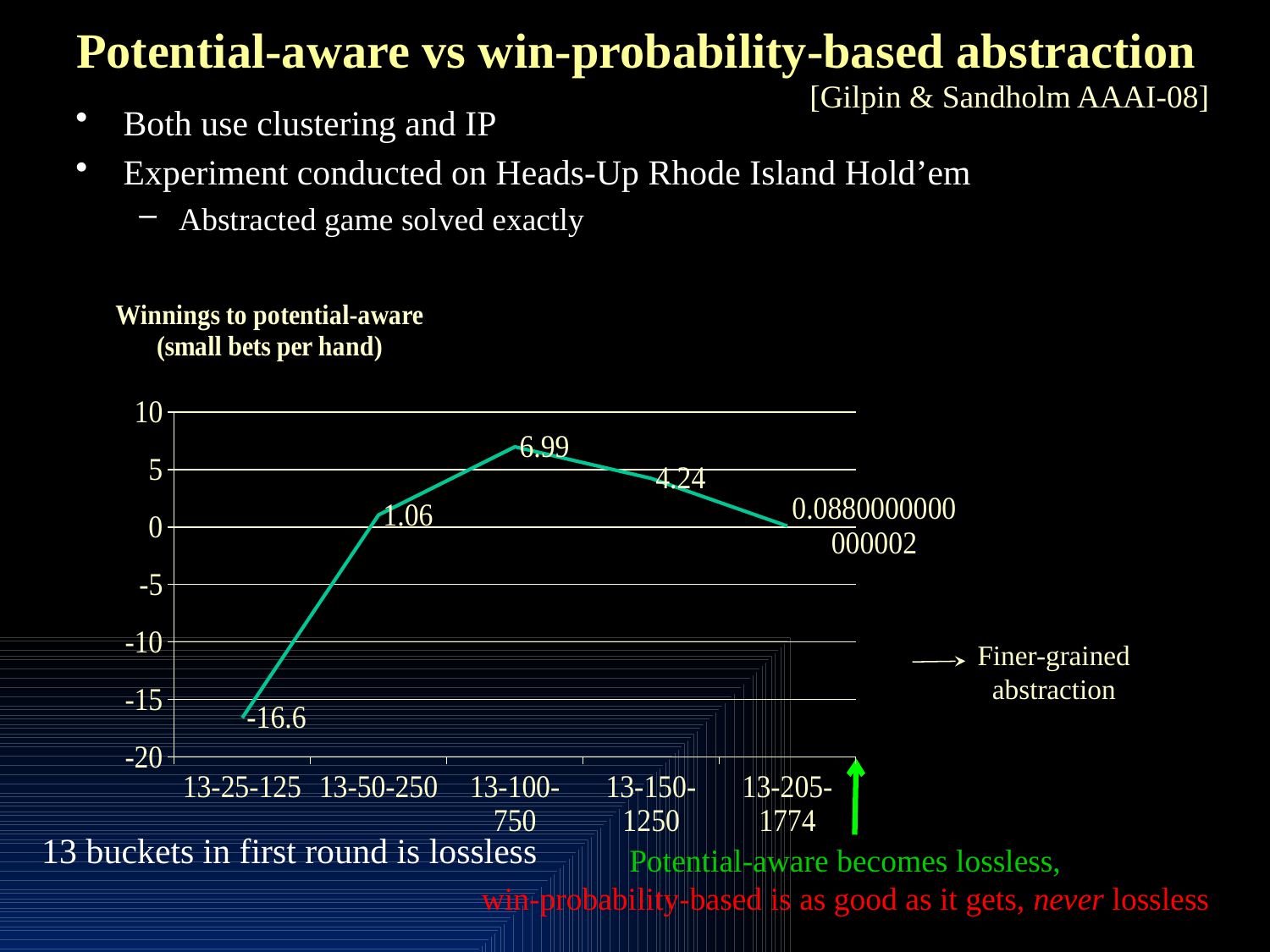
Which abstraction has the lowest winnings to potential-aware? 13-25-125 Is the value for 13-25-125 greater or less than -15? less Which is larger, the value for 13-50-250 or the value for 13-150-1250? 13-150-1250 What is the value for the 13-25-125 abstraction? -16.6 What is the value for the 13-150-1250 abstraction? 4.24 Which abstraction has the highest winnings to potential-aware? 13-100-750 How many abstractions are plotted on the x axis? 5 What is the value for the 13-100-750 abstraction? 6.99 What is the value for the 13-50-250 abstraction? 1.06 What kind of chart is shown on the slide? line chart What is the difference between the values for 13-100-750 and 13-150-1250? 2.75 What is the title of the chart? Winnings to potential-aware (small bets per hand)